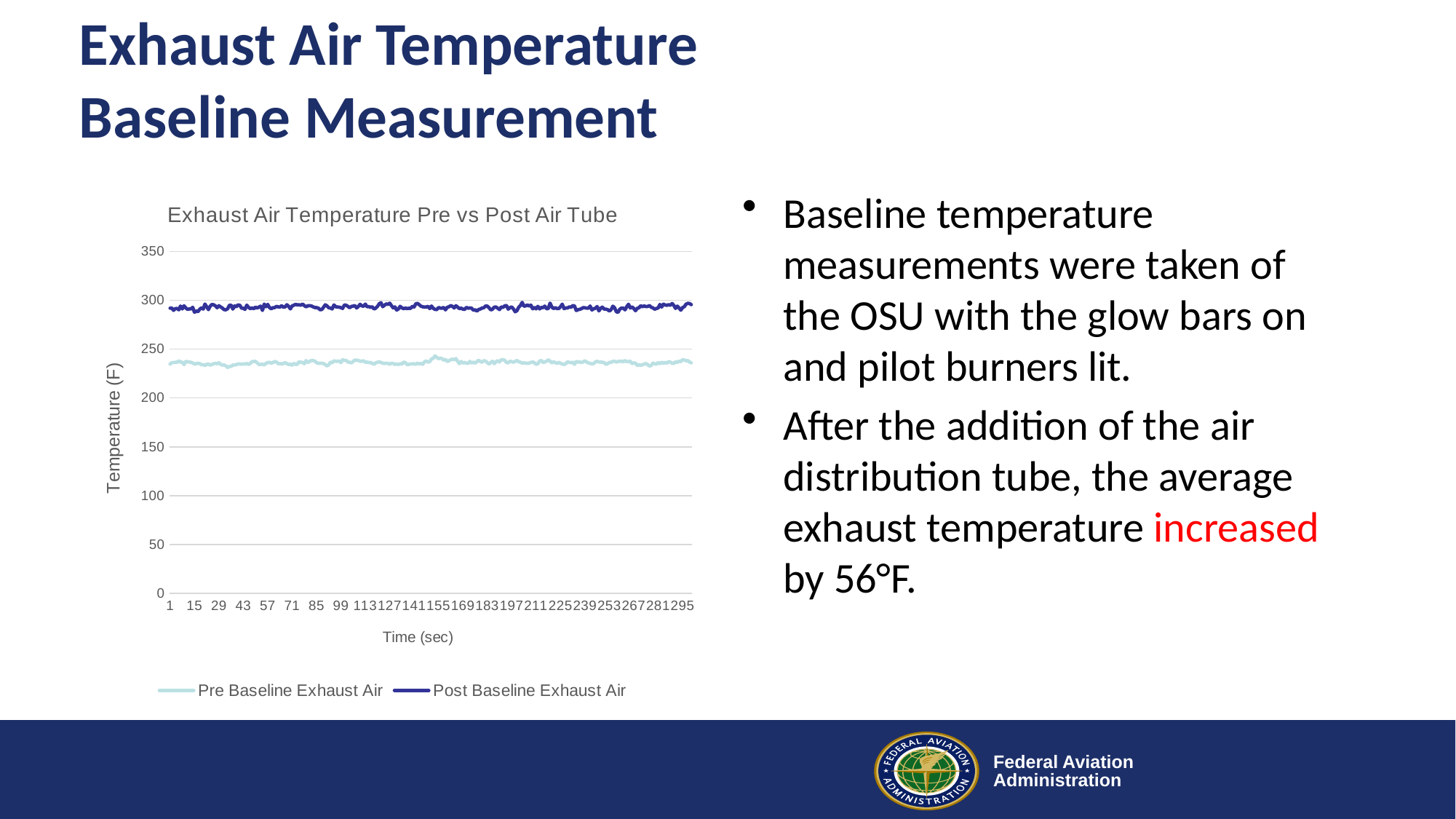
How many series does the chart legend list? 2 Does the Post Baseline Exhaust Air temperature rise sharply, fall sharply, or stay roughly flat over time? stays roughly flat What is the highest value shown on the y axis of the chart? 350 Is the Post Baseline Exhaust Air temperature greater or less than 300? less Is the Post Baseline Exhaust Air temperature greater or less than 250? greater Which series has the higher temperature values, Pre Baseline Exhaust Air or Post Baseline Exhaust Air? Post Baseline Exhaust Air Is the Pre Baseline Exhaust Air temperature greater or less than 200? greater Which series has the lower temperature values over the measurement period? Pre Baseline Exhaust Air What is the title of the chart? Exhaust Air Temperature Pre vs Post Air Tube What kind of chart is shown on the slide? line chart Which series is plotted in dark blue? Post Baseline Exhaust Air